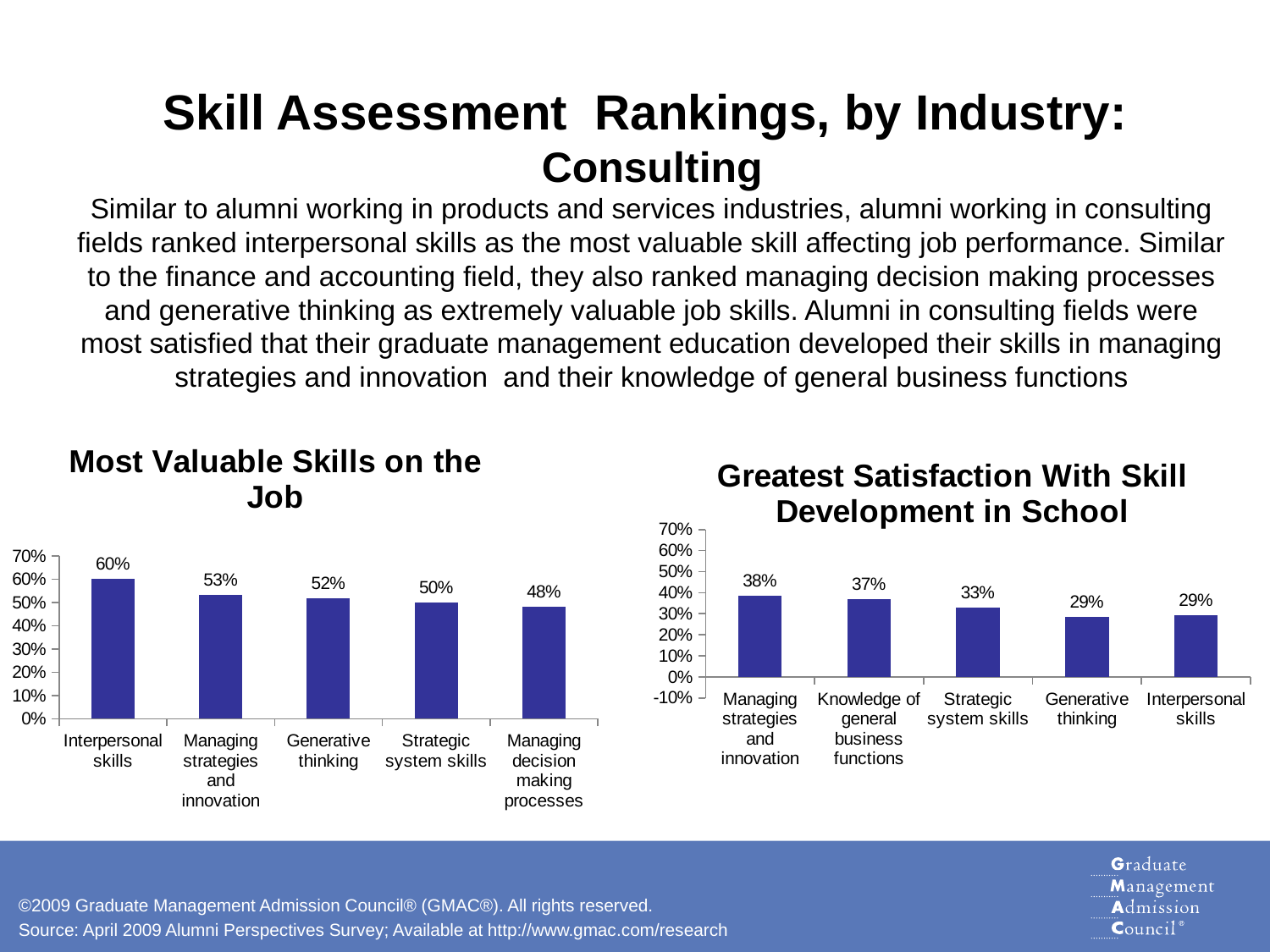
In the 'Most Valuable Skills on the Job' chart, how many categories are shown? 5 What type of chart is the 'Greatest Satisfaction With Skill Development in School' chart? bar chart In the 'Greatest Satisfaction With Skill Development in School' chart, which is larger: Strategic system skills or Generative thinking? Strategic system skills In the 'Greatest Satisfaction With Skill Development in School' chart, what is the value for Knowledge of general business functions? 37% In the 'Most Valuable Skills on the Job' chart, what is the value for Interpersonal skills? 60% In the 'Most Valuable Skills on the Job' chart, what is the value for Generative thinking? 52% In the 'Most Valuable Skills on the Job' chart, do the values rise or fall from left to right? fall In the 'Greatest Satisfaction With Skill Development in School' chart, what is the value for Interpersonal skills? 29% In the 'Greatest Satisfaction With Skill Development in School' chart, what is the difference between Managing strategies and innovation and Strategic system skills? 5% In the 'Greatest Satisfaction With Skill Development in School' chart, which category has the highest value? Managing strategies and innovation In the 'Most Valuable Skills on the Job' chart, what is the difference between Interpersonal skills and Managing strategies and innovation? 7% In the 'Most Valuable Skills on the Job' chart, which category has the lowest value? Managing decision making processes